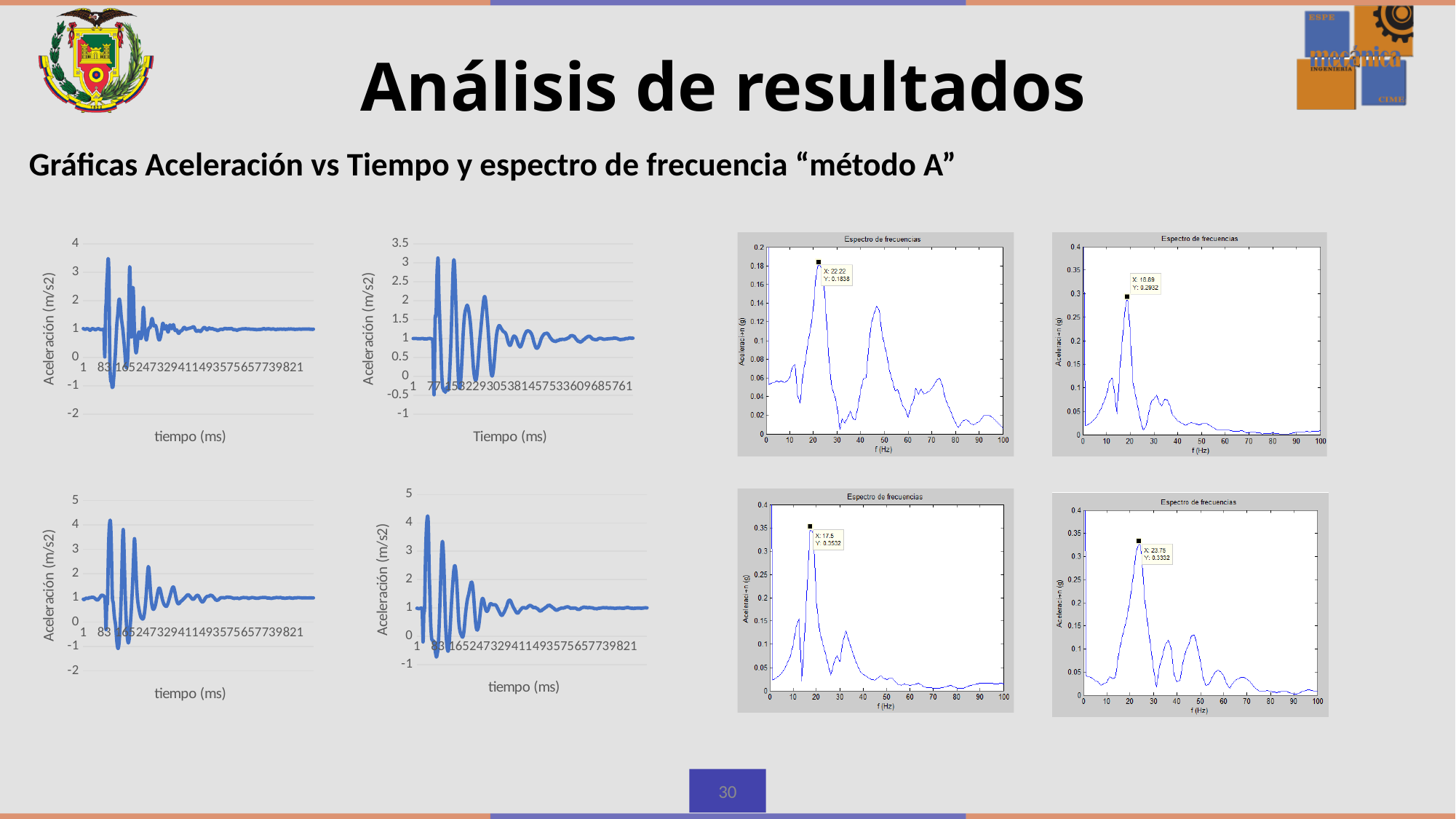
In the top-right spectrum chart, what is the X value of the marked peak? 18.89 What is the difference between the marked peak X values of the bottom-right spectrum chart (23.75) and the bottom-left spectrum chart (17.5)? 6.25 Among the four spectrum charts, which one has the lowest marked peak Y value? top-left (Y: 0.1838) In the top-left acceleration vs time chart, is the maximum acceleration value greater or less than 3? greater In the top-left spectrum chart (Espectro de frecuencias), what is the Y value of the marked peak? 0.1838 What kind of chart is the top-left acceleration vs time chart? line chart In the top-right spectrum chart, what is the Y value of the marked peak? 0.2932 In the bottom-left spectrum chart, what is the Y value of the marked peak? 0.3532 Among the four spectrum charts, which one has the highest marked peak Y value? bottom-left (Y: 0.3532) In the top-left spectrum chart (Espectro de frecuencias), what is the X value of the marked peak? 22.22 In the bottom-right spectrum chart, what is the X value of the marked peak? 23.75 What is the x-axis label of the spectrum charts on the right? f (Hz)